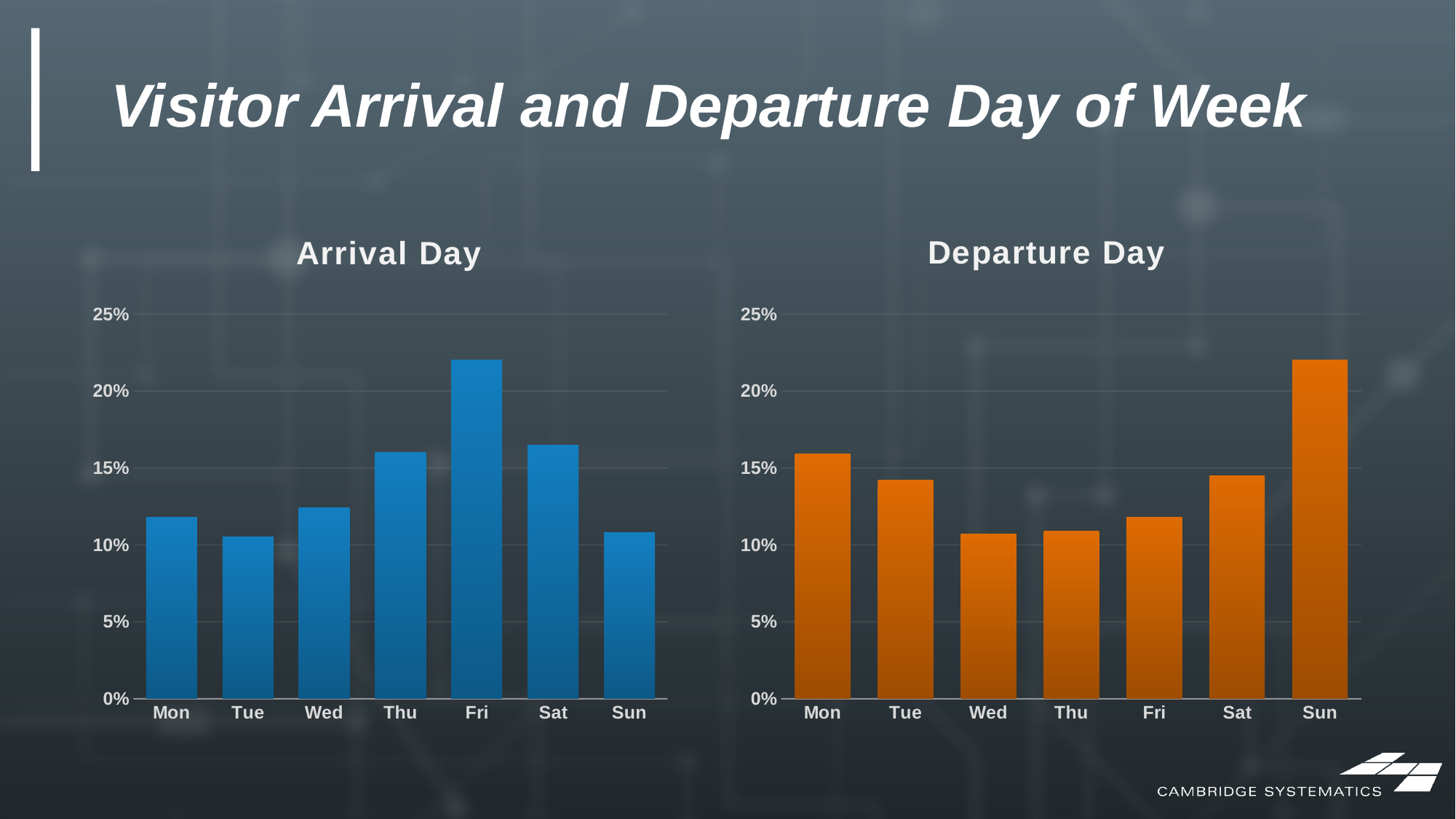
On the Arrival Day chart, is the value for Fri greater or less than 20%? greater What kind of chart is the Departure Day chart? bar chart On the Departure Day chart, is the value for Tue greater or less than 15%? less On the Departure Day chart, which is larger, the value for Mon or the value for Fri? Mon On the Departure Day chart, is the value for Mon greater or less than 15%? greater How many days are shown on the Arrival Day chart? 7 On the Departure Day chart, which day has the highest value? Sun What colour are the bars on the Departure Day chart? orange On the Arrival Day chart, which day has the highest value? Fri On the Arrival Day chart, which is larger, the value for Thu or the value for Mon? Thu